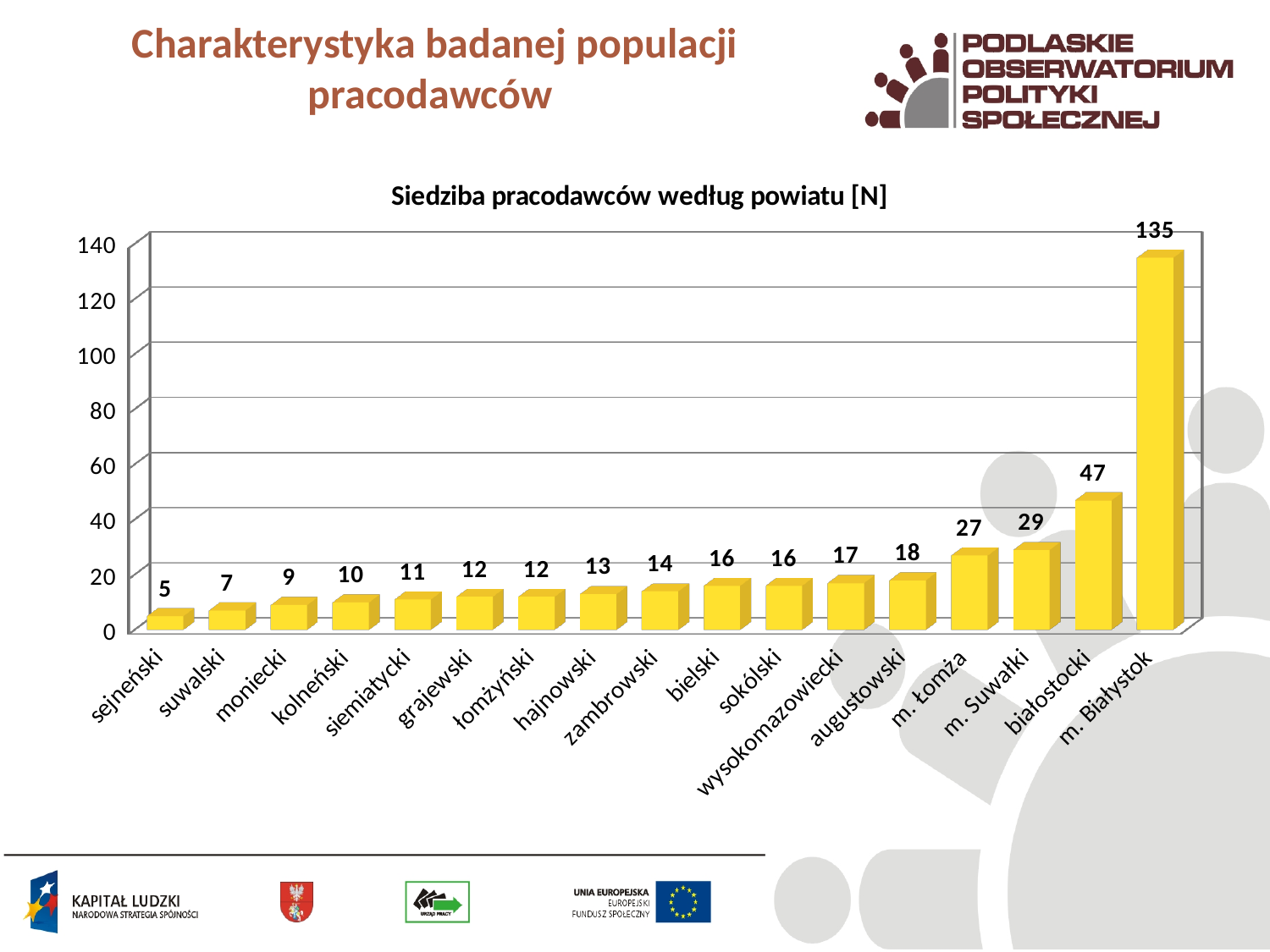
What is the value for augustowski? 18 What is the difference between the values for m. Białystok and białostocki? 88 Which is larger, the value for bielski or the value for moniecki? bielski What is the title of the chart? Siedziba pracodawców według powiatu [N] What is the difference between the values for m. Suwałki and m. Łomża? 2 What kind of chart is this? bar chart What is the value for białostocki? 47 Which powiat has the highest value? m. Białystok Which powiat has the lowest value? sejneński What is the value for sejneński? 5 How many powiats (categories) are shown on the x axis? 17 What is the value for m. Białystok? 135